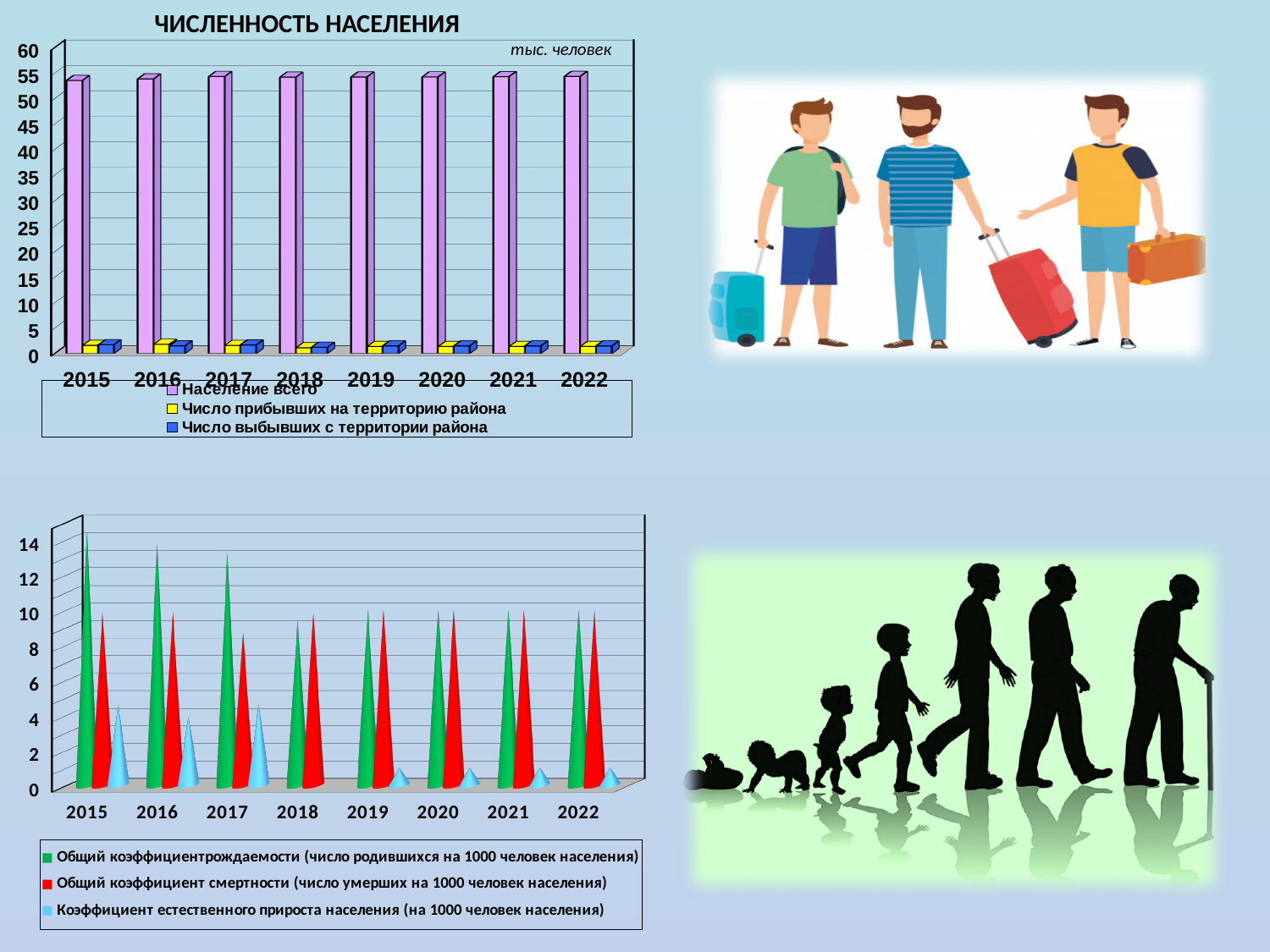
In the bottom chart, which year has the highest value for 'Общий коэффициент рождаемости'? 2015 In the bottom chart, is the value for 'Общий коэффициент рождаемости' in 2015 greater or less than 12? greater What kind of chart is the top chart titled 'ЧИСЛЕННОСТЬ НАСЕЛЕНИЯ'? Bar chart How many series does the legend of the top chart 'ЧИСЛЕННОСТЬ НАСЕЛЕНИЯ' list? 3 How many years are shown on the x axis of the top chart 'ЧИСЛЕННОСТЬ НАСЕЛЕНИЯ'? 8 In the bottom chart, is the value for 'Коэффициент естественного прироста населения' in 2019 greater or less than 2? less In the top chart 'ЧИСЛЕННОСТЬ НАСЕЛЕНИЯ', is the value for 'Число прибывших на территорию района' in 2022 greater or less than 5? less In the top chart 'ЧИСЛЕННОСТЬ НАСЕЛЕНИЯ', what unit is stated in the top-right corner of the plot area? тыс. человек In the top chart 'ЧИСЛЕННОСТЬ НАСЕЛЕНИЯ', which series has the highest values in every year? Население всего In the bottom chart, does the value for 'Общий коэффициент рождаемости' rise or fall from 2015 to 2022? Fall How many series does the legend of the bottom chart list? 3